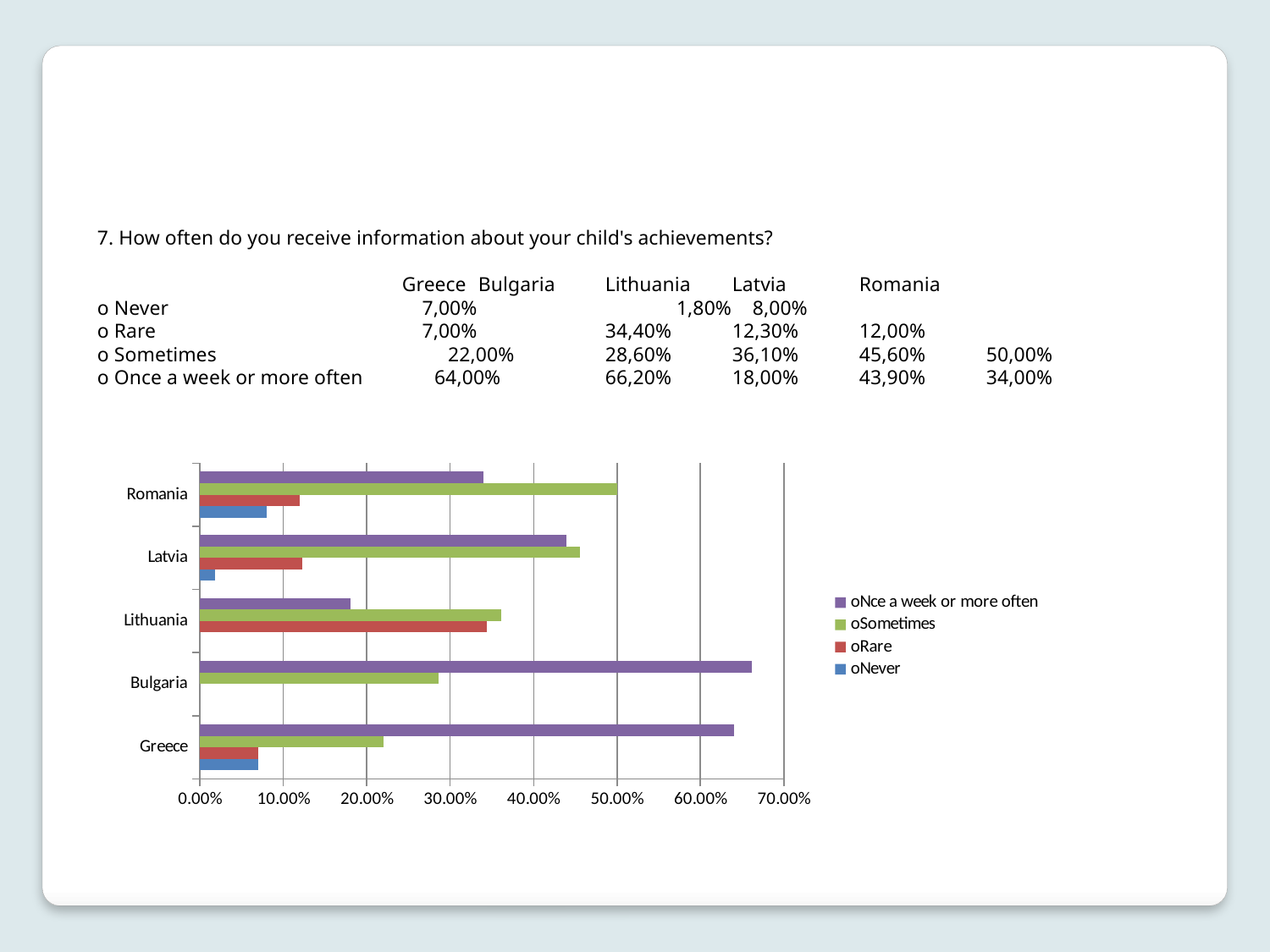
How many series does the chart legend list? 4 What kind of chart is shown on the slide? bar chart For Lithuania, which is larger: 'Once a week or more often' or 'Sometimes'? Sometimes For Greece, which is larger: 'Once a week or more often' or 'Sometimes'? Once a week or more often What is the 'Sometimes' value for Romania? 50,00% Which country has the highest value for 'Sometimes'? Romania How many countries are shown on the chart's vertical axis? 5 Which country has the lowest value for 'Once a week or more often'? Lithuania Is the 'Never' value for Romania greater or less than 10.00%? less Is the 'Once a week or more often' value for Lithuania greater or less than 20.00%? less Which colour represents the 'Never' series in the chart? blue Is the 'Once a week or more often' value for Bulgaria greater or less than 60.00%? greater